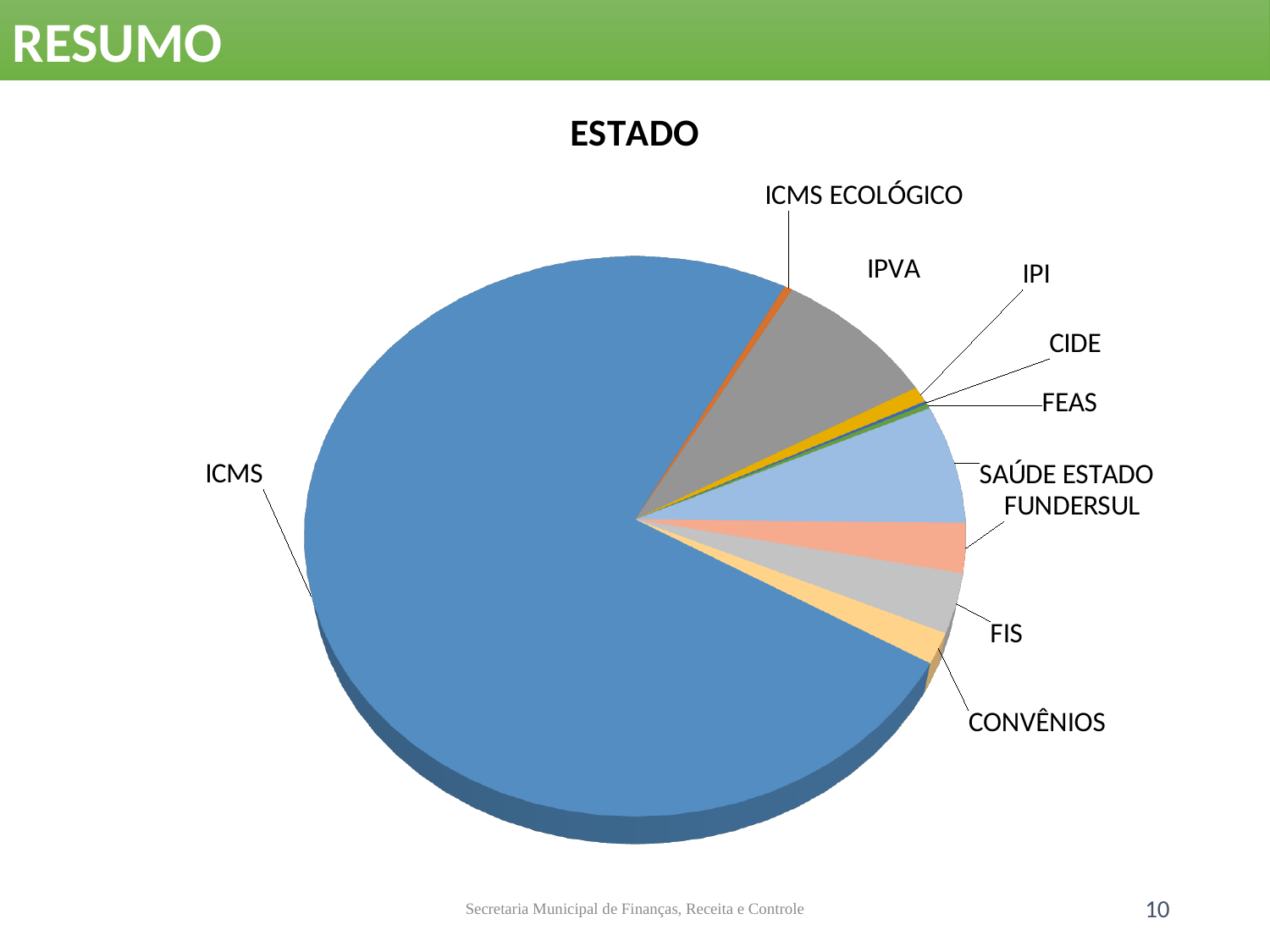
What kind of chart is shown on the slide? Pie chart What is the title of the chart? ESTADO Which slice is larger, IPVA or ICMS ECOLÓGICO? IPVA Which category has the largest slice of the pie? ICMS Which slice is larger, SAÚDE ESTADO or FUNDERSUL? SAÚDE ESTADO Which slice is larger, IPVA or FIS? IPVA How many slices does the pie chart have? 10 What colour is the ICMS slice? Blue